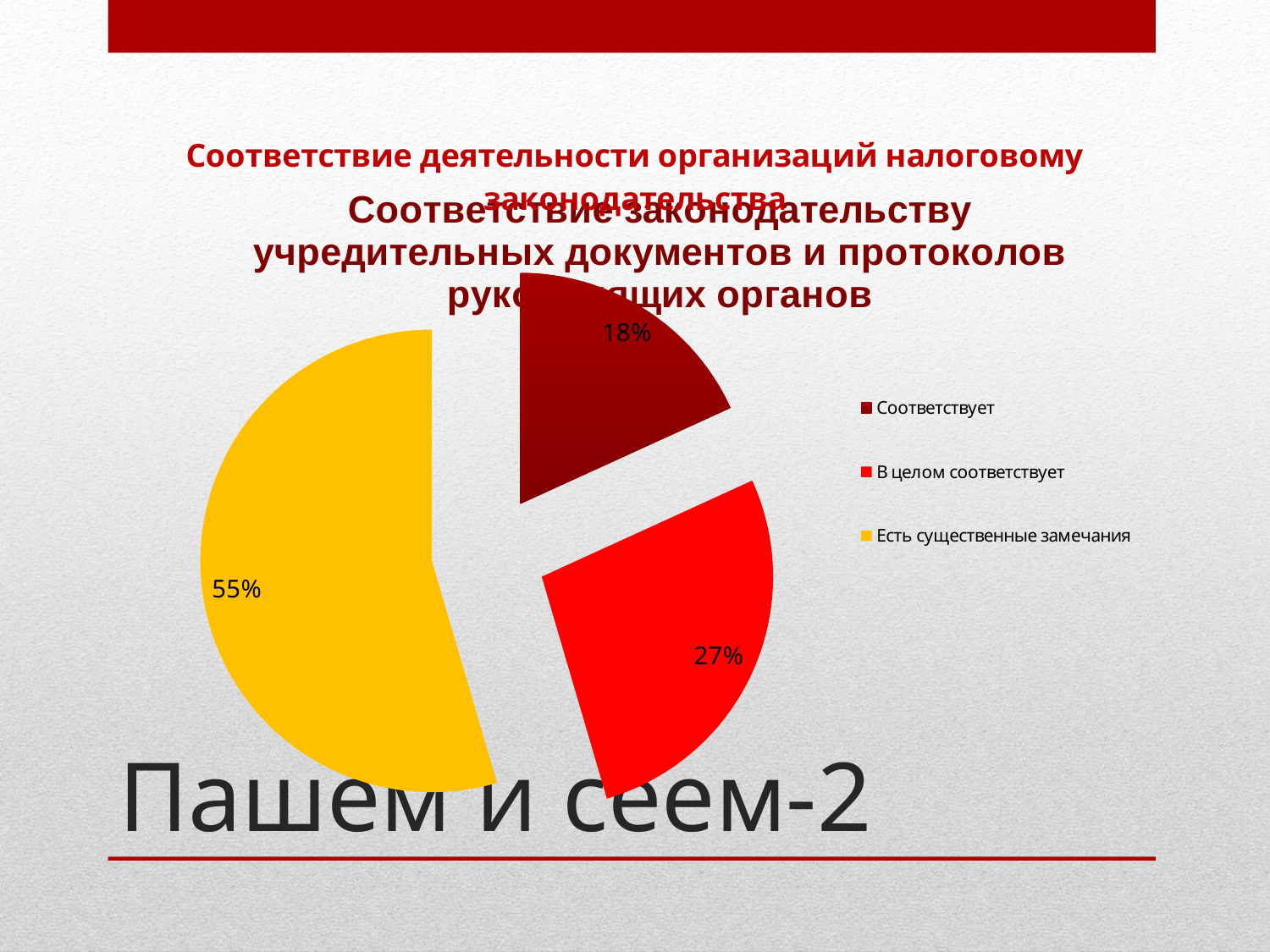
Which category has the largest slice of the pie? Есть существенные замечания How many slices does the pie chart have? 3 What share of the pie does "В целом соответствует" have? 27% Which category has the smallest slice of the pie? Соответствует How many entries does the legend list? 3 What is the difference in percentage points between "В целом соответствует" and "Соответствует"? 9 What share of the pie does "Соответствует" have? 18% What colour is the slice for "Есть существенные замечания"? yellow What is the difference in percentage points between "Есть существенные замечания" and "В целом соответствует"? 28 Which is larger: the slice for "В целом соответствует" or the slice for "Соответствует"? В целом соответствует What kind of chart is shown on the slide? pie chart What share of the pie does "Есть существенные замечания" have? 55%